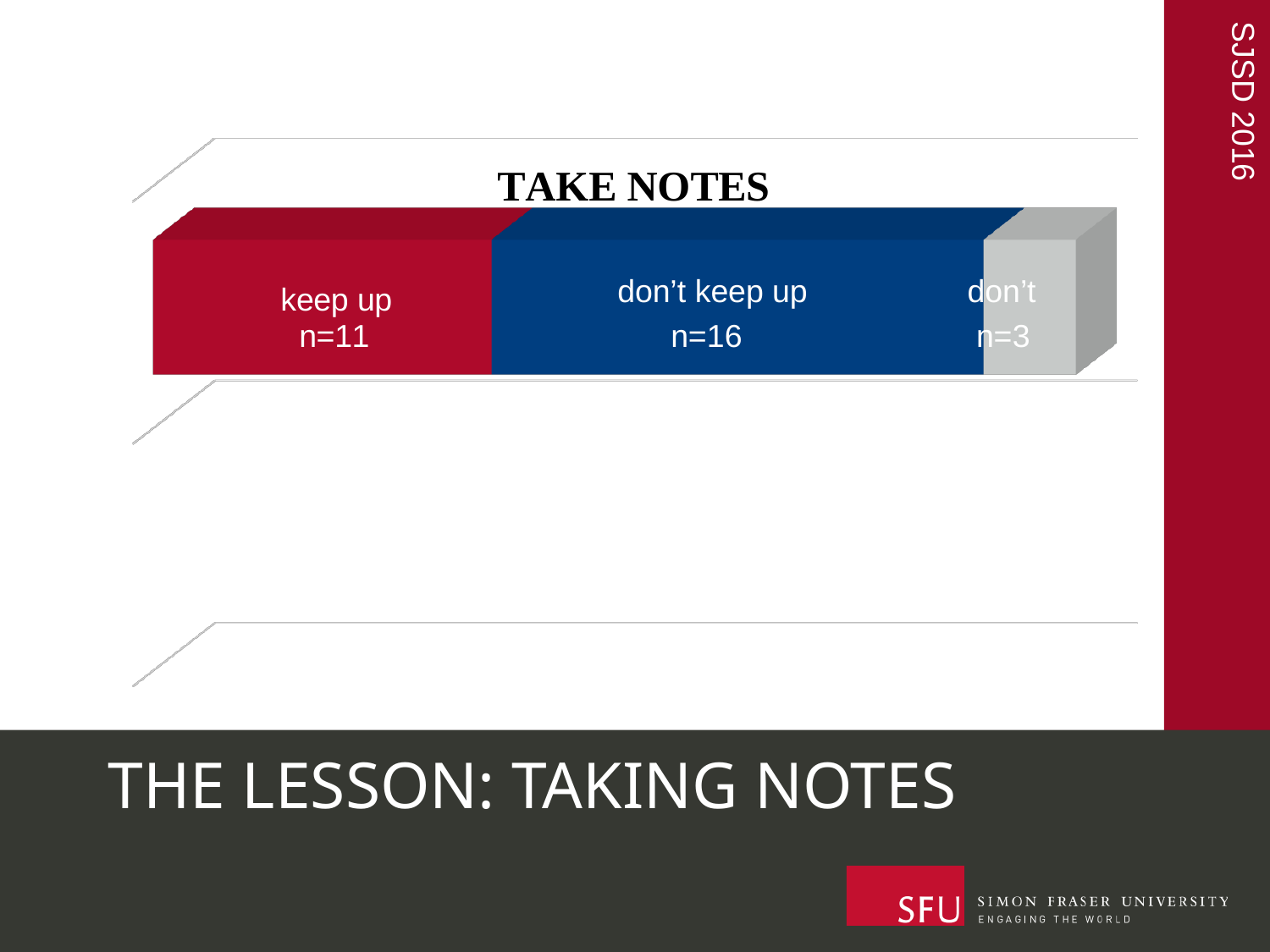
What is the value for the "don't" segment? n=3 What kind of chart is shown on the slide? bar chart What colour is the "keep up" segment? red What is the value for the "don't keep up" segment? n=16 What is the total of all segments in the stacked bar? 30 What is the title of the chart? TAKE NOTES Which segment has the highest value? don't keep up Which segment has the lowest value? don't What is the value for the "keep up" segment? n=11 Which is larger, "keep up" or "don't"? keep up What is the difference between the "don't keep up" and "keep up" values? 5 How many segments make up the stacked bar? 3